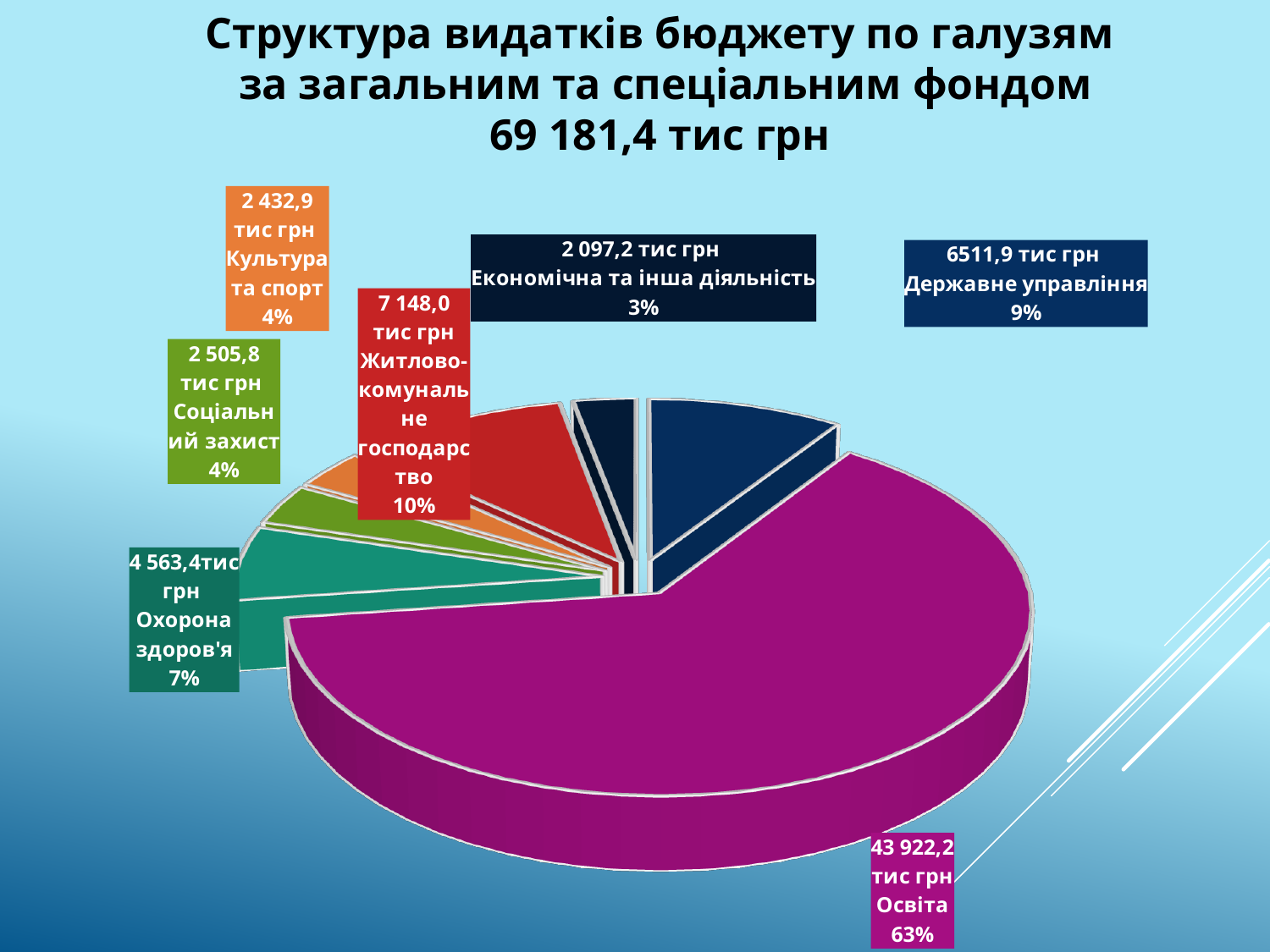
What total amount is stated in the chart title? 69 181,4 тис грн What share of the pie does Освіта represent? 63% Which is larger, the value for Державне управління or the value for Житлово-комунальне господарство? Житлово-комунальне господарство What is the value for Охорона здоров'я? 4 563,4 тис грн What is the value for Освіта? 43 922,2 тис грн What is the value for Житлово-комунальне господарство? 7 148,0 тис грн Which category has the largest slice of the pie? Освіта How many slices does the pie chart have? 7 What is the difference between the value for Соціальний захист and the value for Культура та спорт? 72,9 тис грн What kind of chart is shown on the slide? pie chart Which category has the smallest slice of the pie? Економічна та інша діяльність What share of the pie does Державне управління represent? 9%